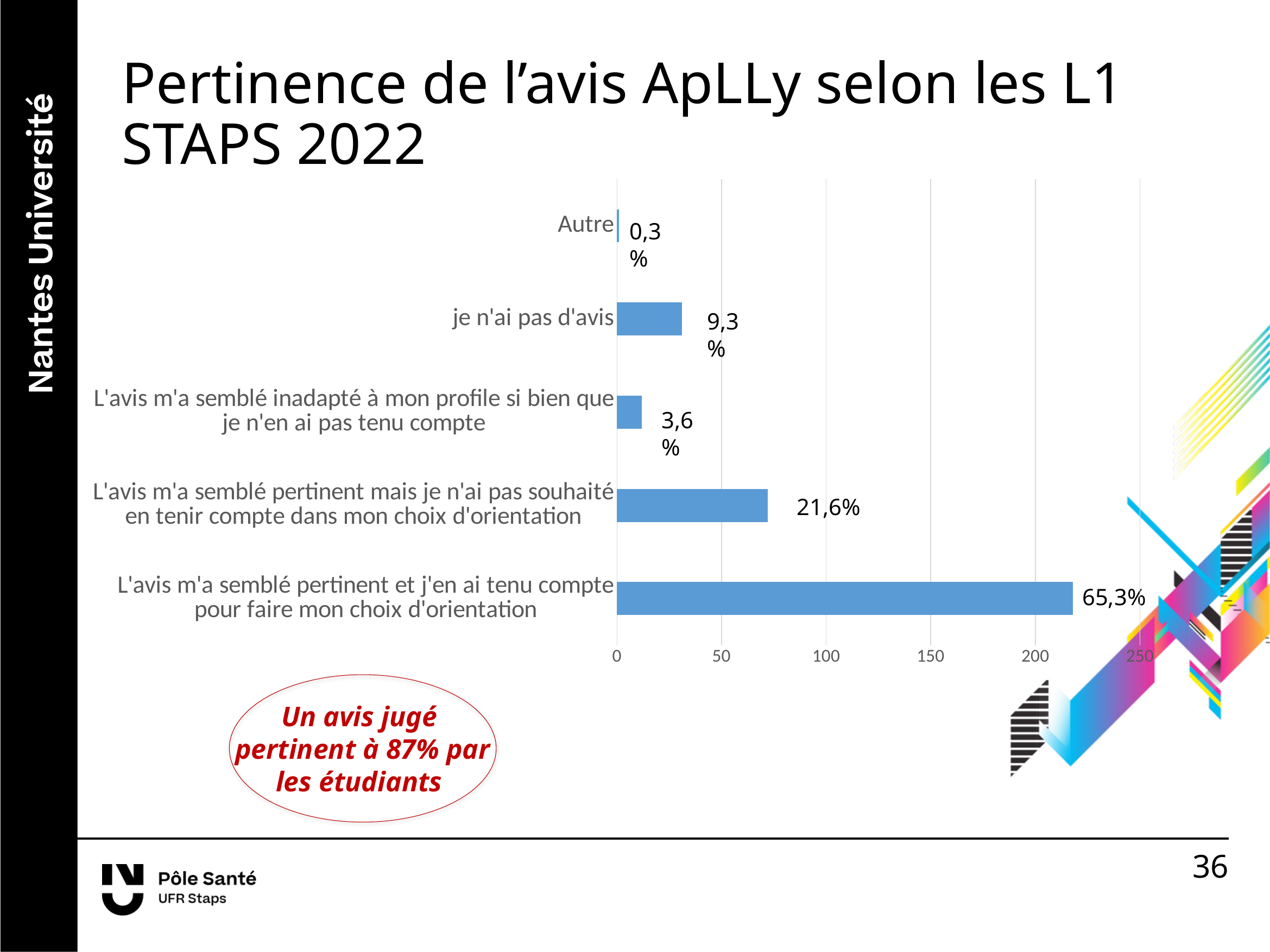
Which is larger: the value for "je n'ai pas d'avis" or the value for "L'avis m'a semblé inadapté à mon profile si bien que je n'en ai pas tenu compte"? je n'ai pas d'avis How many categories does the chart show? 5 Is the bar for "je n'ai pas d'avis" greater or less than 50 on the axis? less What kind of chart is shown on the slide? bar chart What is the data label for "L'avis m'a semblé pertinent mais je n'ai pas souhaité en tenir compte dans mon choix d'orientation"? 21,6% What is the data label for "je n'ai pas d'avis"? 9,3% Which category has the highest value? L'avis m'a semblé pertinent et j'en ai tenu compte pour faire mon choix d'orientation Is the bar for "L'avis m'a semblé pertinent et j'en ai tenu compte pour faire mon choix d'orientation" greater or less than 200 on the axis? greater Which category has the lowest value? Autre What is the data label for "L'avis m'a semblé pertinent et j'en ai tenu compte pour faire mon choix d'orientation"? 65,3% What is the data label for "Autre"? 0,3% What is the difference in percentage points between the labels for "L'avis m'a semblé pertinent et j'en ai tenu compte pour faire mon choix d'orientation" and "L'avis m'a semblé pertinent mais je n'ai pas souhaité en tenir compte dans mon choix d'orientation"? 43,7%